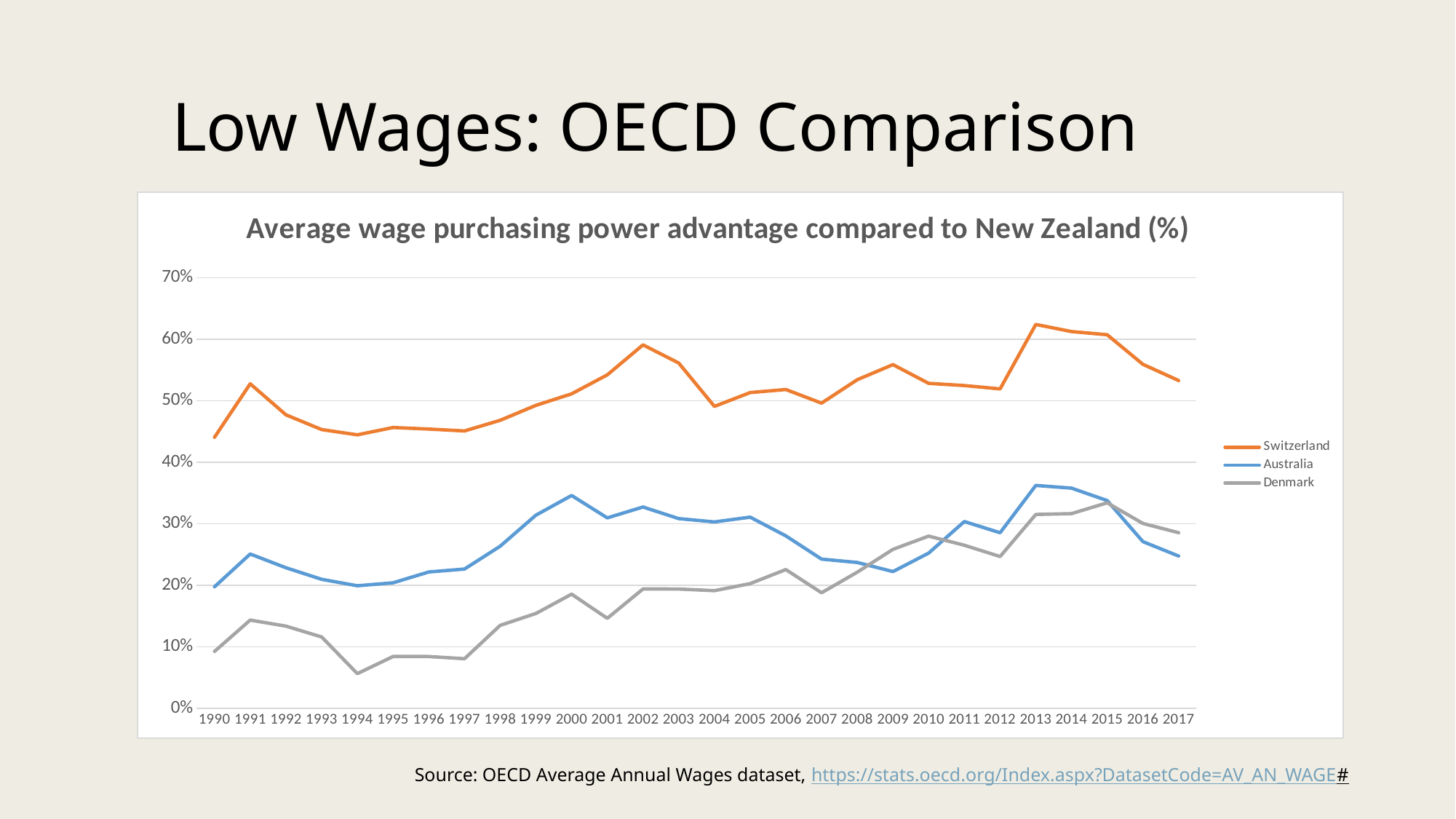
In which year is Denmark's value at its lowest? 1994 What kind of chart is shown on the slide? line chart How many years are plotted along the x axis? 28 Does the Switzerland line rise or fall from 2013 to 2017? fall Is the value for Switzerland in 2013 greater or less than 60%? greater Which country has the lowest purchasing power advantage in 1990? Denmark Is the value for Denmark in 1994 greater or less than 10%? less What is the title of the chart? Average wage purchasing power advantage compared to New Zealand (%) Which country has the highest purchasing power advantage in 2017? Switzerland In 2002, which is larger: the value for Australia or the value for Denmark? Australia Is the value for Switzerland in 1990 greater or less than 50%? less How many series does the legend list? 3